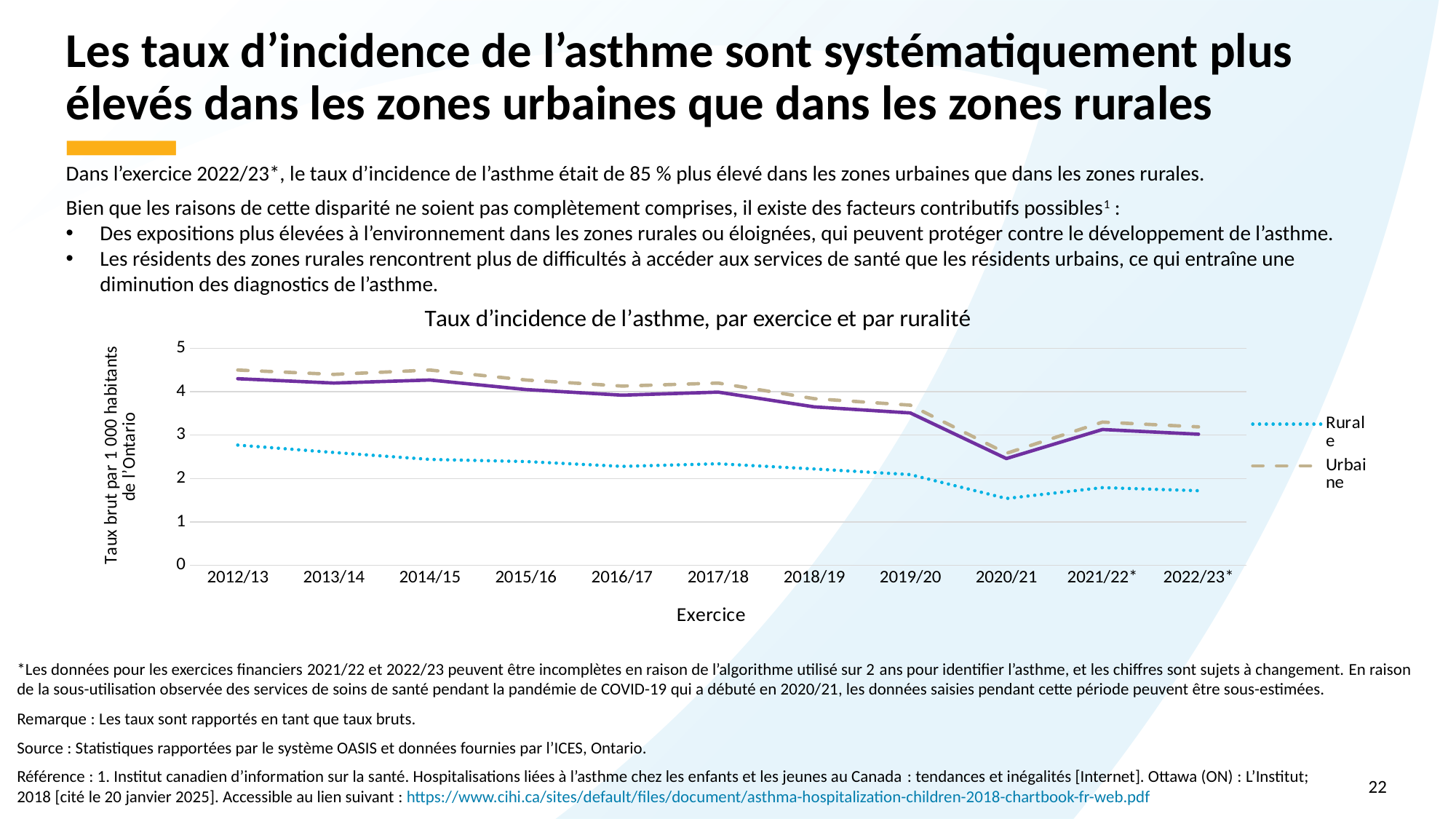
What kind of chart is shown on the slide? Line chart In 2022/23*, which series has the higher value, Rurale or Urbaine? Urbaine Is the value for Rurale in 2020/21 greater or less than 2? less Is the value for Urbaine in 2020/21 greater or less than 3? less In which fiscal year is the Rurale series at its lowest? 2020/21 Is the value for Urbaine in 2012/13 greater or less than 4? greater How many fiscal years (exercices) are shown on the x axis of the chart? 11 How many series does the chart legend list? 2 In which fiscal year is the Rurale series at its highest? 2012/13 What is the title of the chart? Taux d’incidence de l’asthme, par exercice et par ruralité